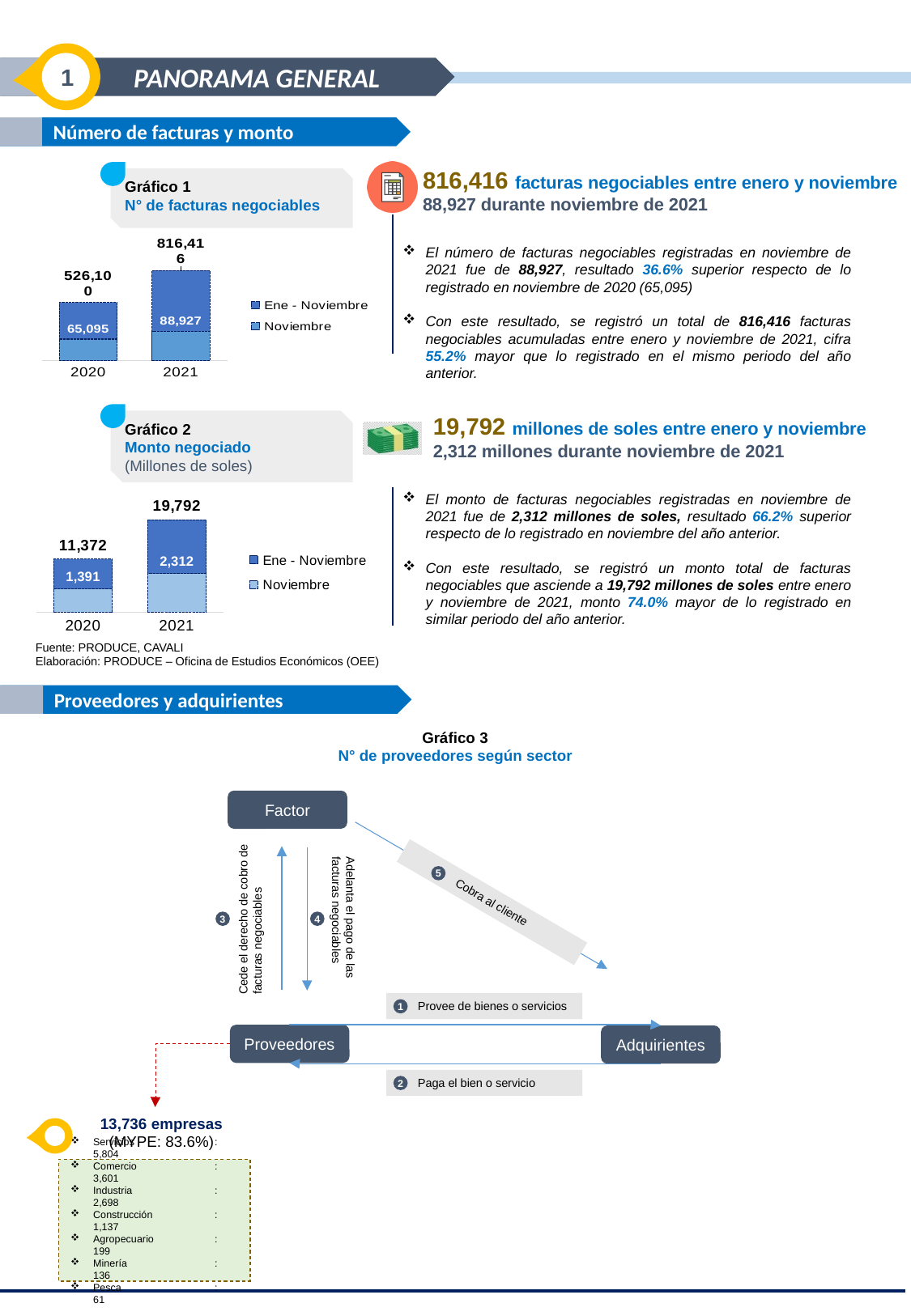
In Gráfico 1 (N° de facturas negociables), what is the difference between the Noviembre values for 2021 and 2020? 23,832 In Gráfico 1 (N° de facturas negociables), how many series does the legend list? 2 In Gráfico 2 (Monto negociado), what is the Noviembre value for 2021? 2,312 In Gráfico 1 (N° de facturas negociables), which year has the higher Ene - Noviembre value? 2021 In Gráfico 1 (N° de facturas negociables), what is the Noviembre value for 2020? 65,095 In Gráfico 2 (Monto negociado), what is the difference between the Ene - Noviembre values for 2021 and 2020? 8,420 What kind of chart is Gráfico 2 (Monto negociado)? Bar chart In Gráfico 2 (Monto negociado), what is the Ene - Noviembre value for 2020? 11,372 In Gráfico 2 (Monto negociado), what unit is stated in the chart subtitle? Millones de soles In Gráfico 1 (N° de facturas negociables), what is the Ene - Noviembre value for 2021? 816,416 In Gráfico 2 (Monto negociado), how many years are shown on the x axis? 2 In Gráfico 2 (Monto negociado), which year has the lower Noviembre value? 2020